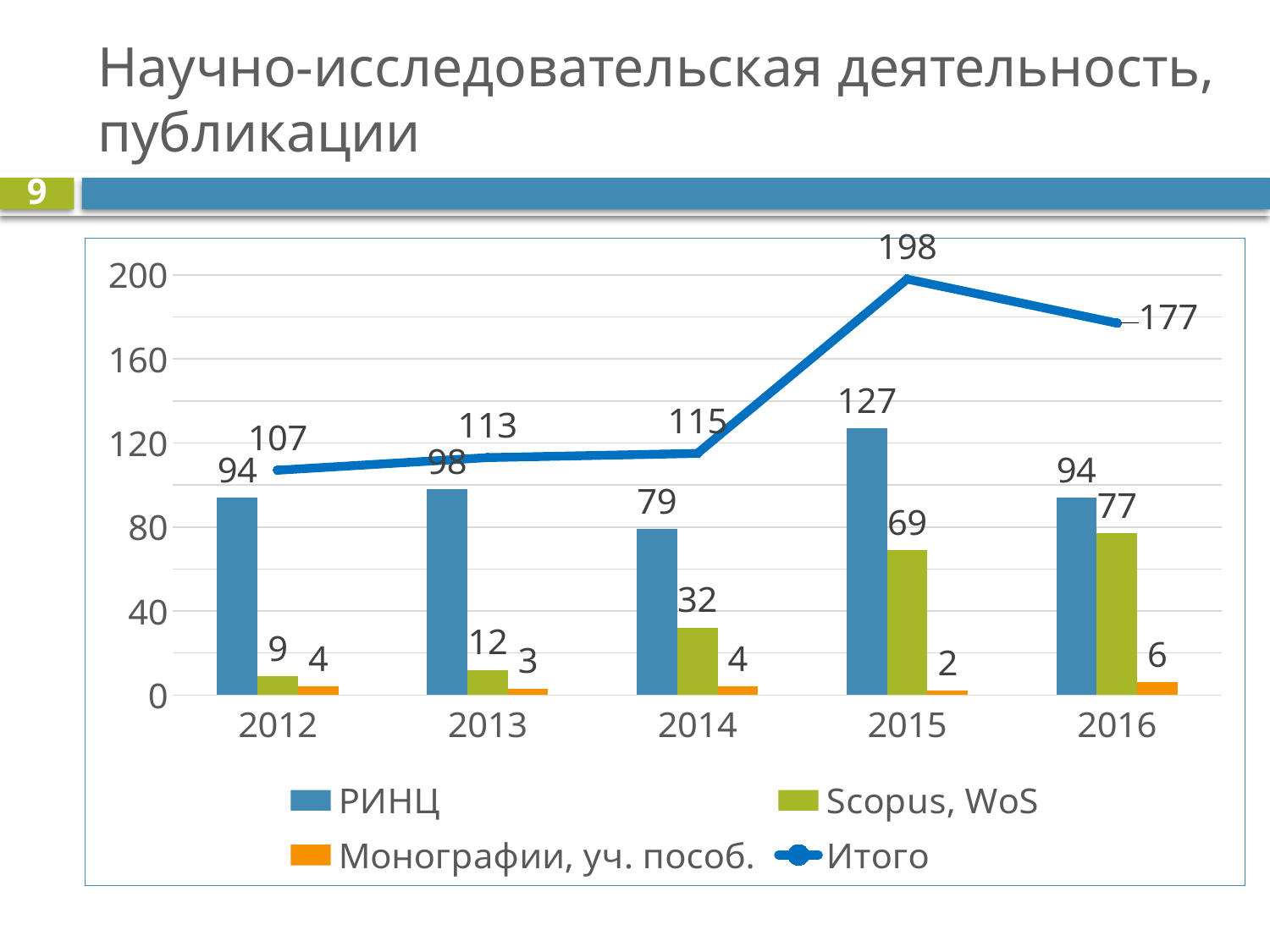
How many years are shown on the x axis? 5 What is the value of the Итого line in 2014? 115 What is the value for Монографии, уч. пособ. in 2013? 3 What is the difference between the Итого values for 2015 and 2016? 21 In which year is the Итого line highest? 2015 What is the value for РИНЦ in 2015? 127 Does the Scopus, WoS series rise or fall from 2012 to 2016? rise How many series does the legend list? 4 What is the value for Scopus, WoS in 2016? 77 Which series is shown as a line rather than bars? Итого Which is larger in 2016: РИНЦ or Scopus, WoS? РИНЦ In which year is the Scopus, WoS value lowest? 2012